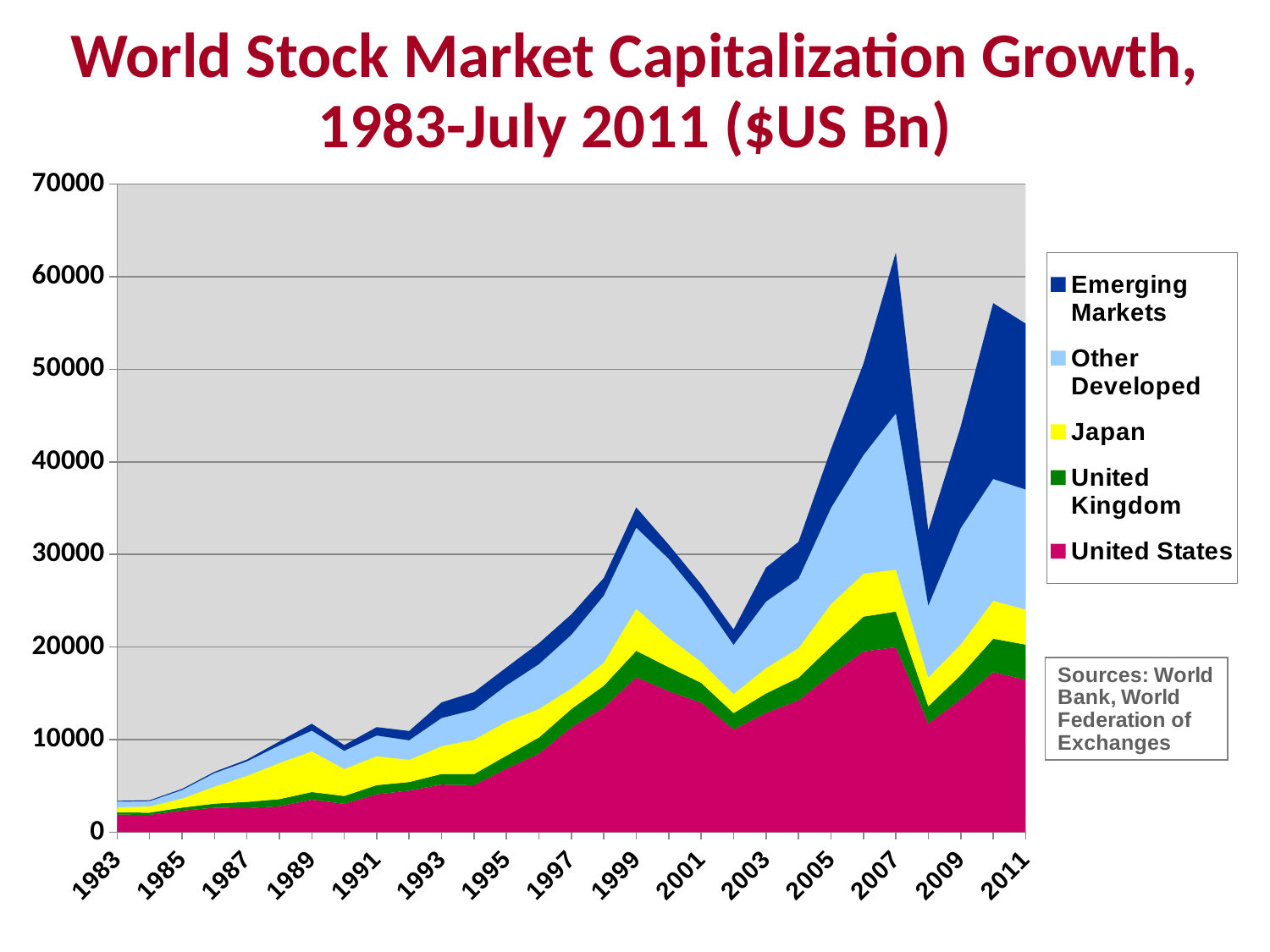
In which year does the total world stock market capitalization reach its highest point? 2007 Is the total world stock market capitalization in 1983 greater or less than 10000? less What kind of chart is shown on the slide? Stacked area chart Is the total world stock market capitalization in 1999 greater or less than 30000? greater Which series is plotted at the bottom of the stack? United States Overall, does the total world stock market capitalization rise or fall from 1983 to 2011? Rise Which is larger, the total world stock market capitalization in 2007 or in 2011? 2007 Is the total world stock market capitalization in 2007 greater or less than 50000? greater How many series does the legend list? 5 What is the title of the chart? World Stock Market Capitalization Growth, 1983-July 2011 ($US Bn) How many year labels are shown on the x axis? 15